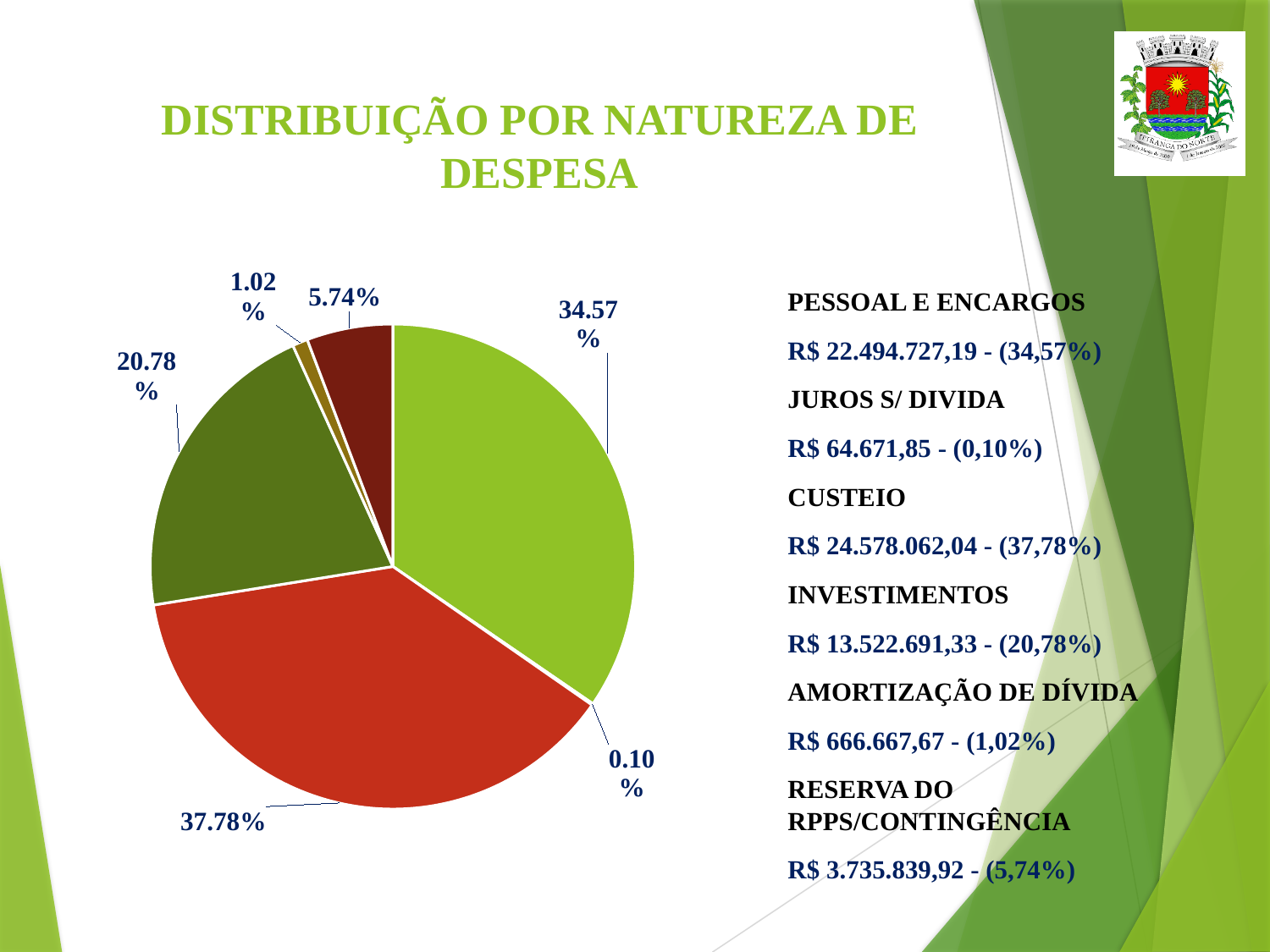
What is the title of the slide containing the pie chart? DISTRIBUIÇÃO POR NATUREZA DE DESPESA Which slice is larger, INVESTIMENTOS or RESERVA DO RPPS/CONTINGÊNCIA? INVESTIMENTOS Which category has the smallest slice of the pie chart? JUROS S/ DIVIDA What percentage is shown for INVESTIMENTOS in the pie chart? 20.78% What percentage is shown for RESERVA DO RPPS/CONTINGÊNCIA in the pie chart? 5.74% What kind of chart is shown on the slide? Pie chart What is the difference in percentage points between the CUSTEIO slice and the PESSOAL E ENCARGOS slice? 3.21 What is the value in R$ listed for CUSTEIO next to the pie chart? R$ 24.578.062,04 What share of the pie does PESSOAL E ENCARGOS represent? 34.57% Which category has the largest slice of the pie chart? CUSTEIO What percentage is shown for AMORTIZAÇÃO DE DÍVIDA in the pie chart? 1.02% How many slices does the pie chart have? 6